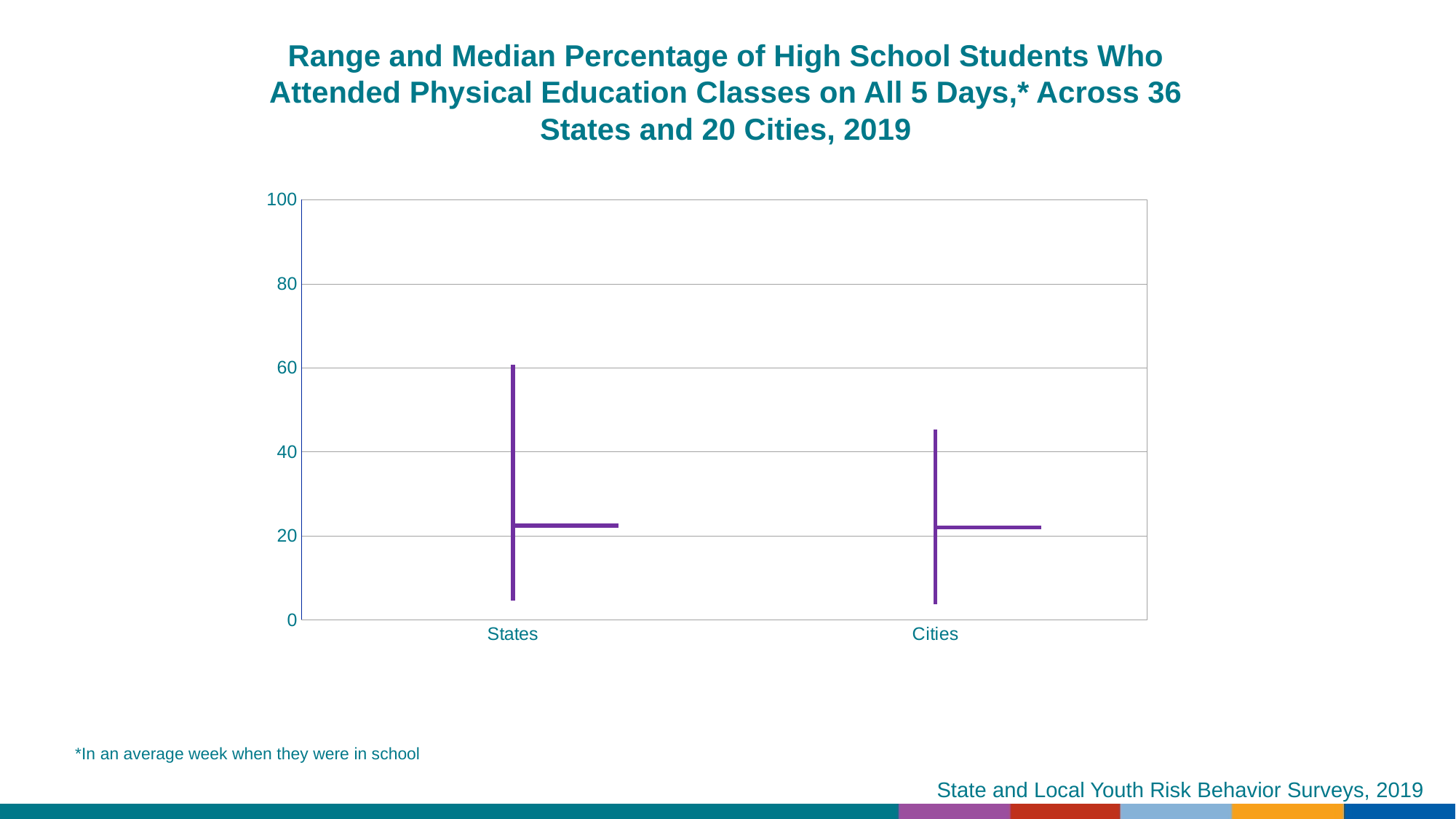
Is the top of the range for Cities greater or less than 60? less Is the median for States greater or less than 40? less How many categories are shown on the x axis of the chart? 2 Is the median for Cities greater or less than 40? less Which category has the higher top of its range, States or Cities? States What are the two categories shown on the x axis? States and Cities What is the highest value shown on the y axis? 100 What kind of chart is shown on the slide? range (high-low) chart with median markers